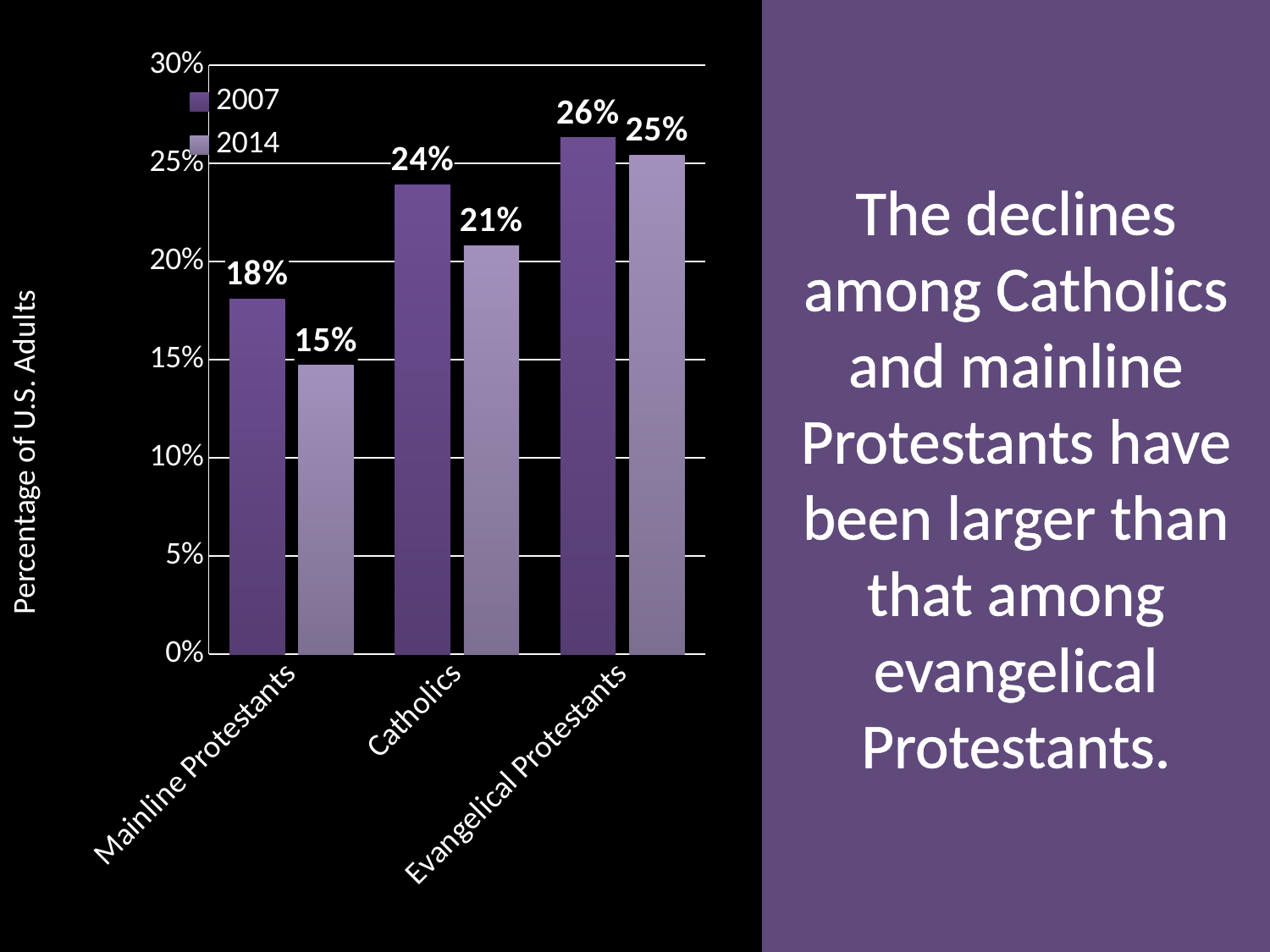
Which group had the highest percentage of U.S. adults in 2014? Evangelical Protestants What kind of chart is shown on the slide? Bar chart Which group had the lowest percentage of U.S. adults in 2007? Mainline Protestants How many groups are shown on the x axis? 3 What was the percentage of U.S. adults who were Catholics in 2014? 21% What is the difference between the 2014 values for Evangelical Protestants and Mainline Protestants? 10% What was the percentage of U.S. adults who were Mainline Protestants in 2007? 18% What was the percentage of U.S. adults who were Evangelical Protestants in 2007? 26% Which is larger: the 2007 value for Catholics or the 2014 value for Evangelical Protestants? 2014 value for Evangelical Protestants What is the label on the vertical axis? Percentage of U.S. Adults By how many percentage points did the share of Catholics fall from 2007 to 2014? 3% How many series does the legend list? 2